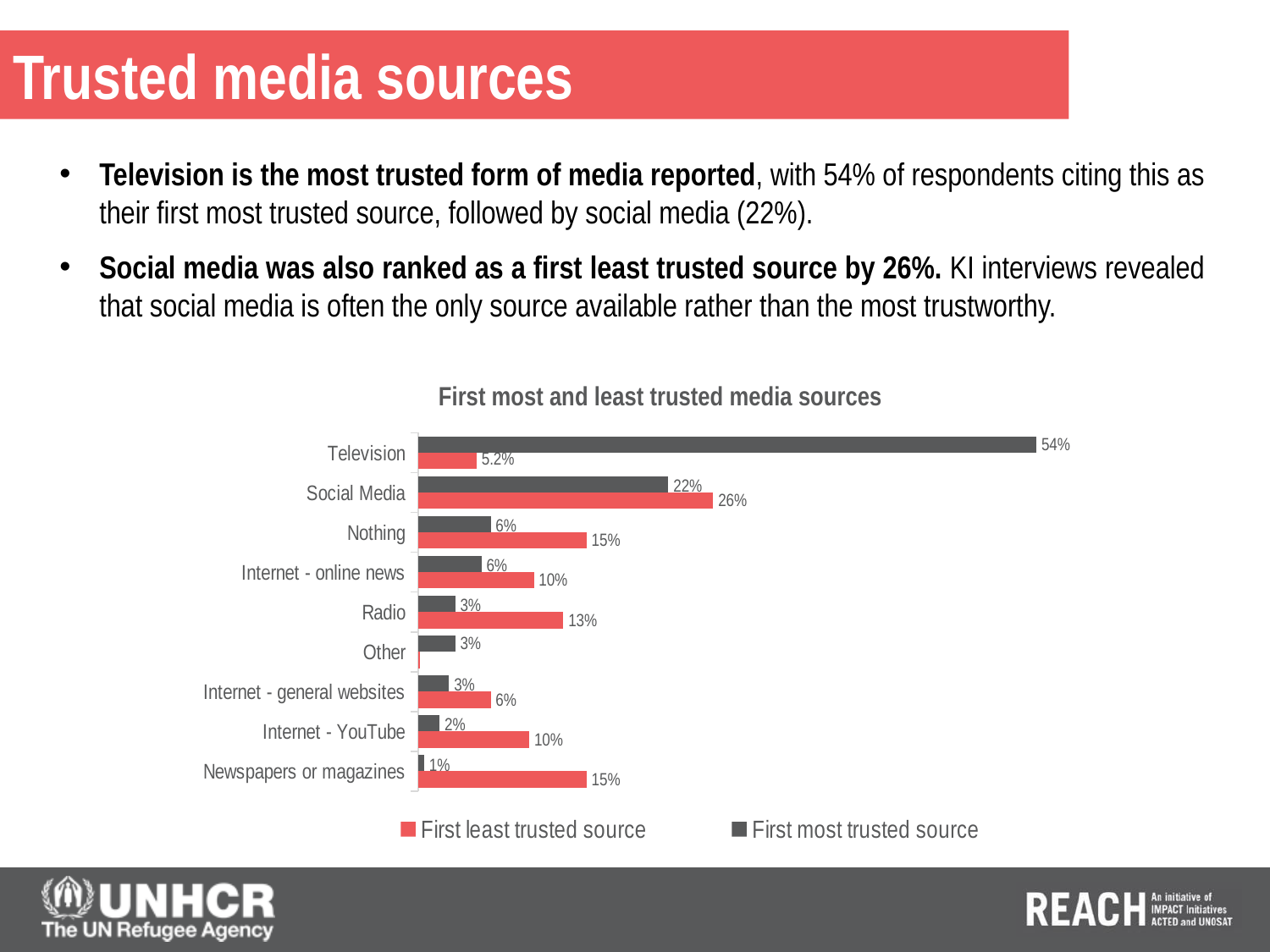
Which category has the lowest value in the 'First most trusted source' series? Newspapers or magazines What is the value for Television in the 'First most trusted source' series? 54% Which category has the highest value in the 'First most trusted source' series? Television What is the value for Social Media in the 'First least trusted source' series? 26% What is the 'First least trusted source' value for Radio? 13% How many media source categories are shown in the chart? 9 What is the difference between the 'First most trusted source' values for Television and Social Media? 32% What is the title of the chart? First most and least trusted media sources What is the 'First least trusted source' value for Television? 5.2% For Social Media, which is larger: the 'First least trusted source' value or the 'First most trusted source' value? First least trusted source What type of chart is shown on the slide? Bar chart How many series does the legend list? 2